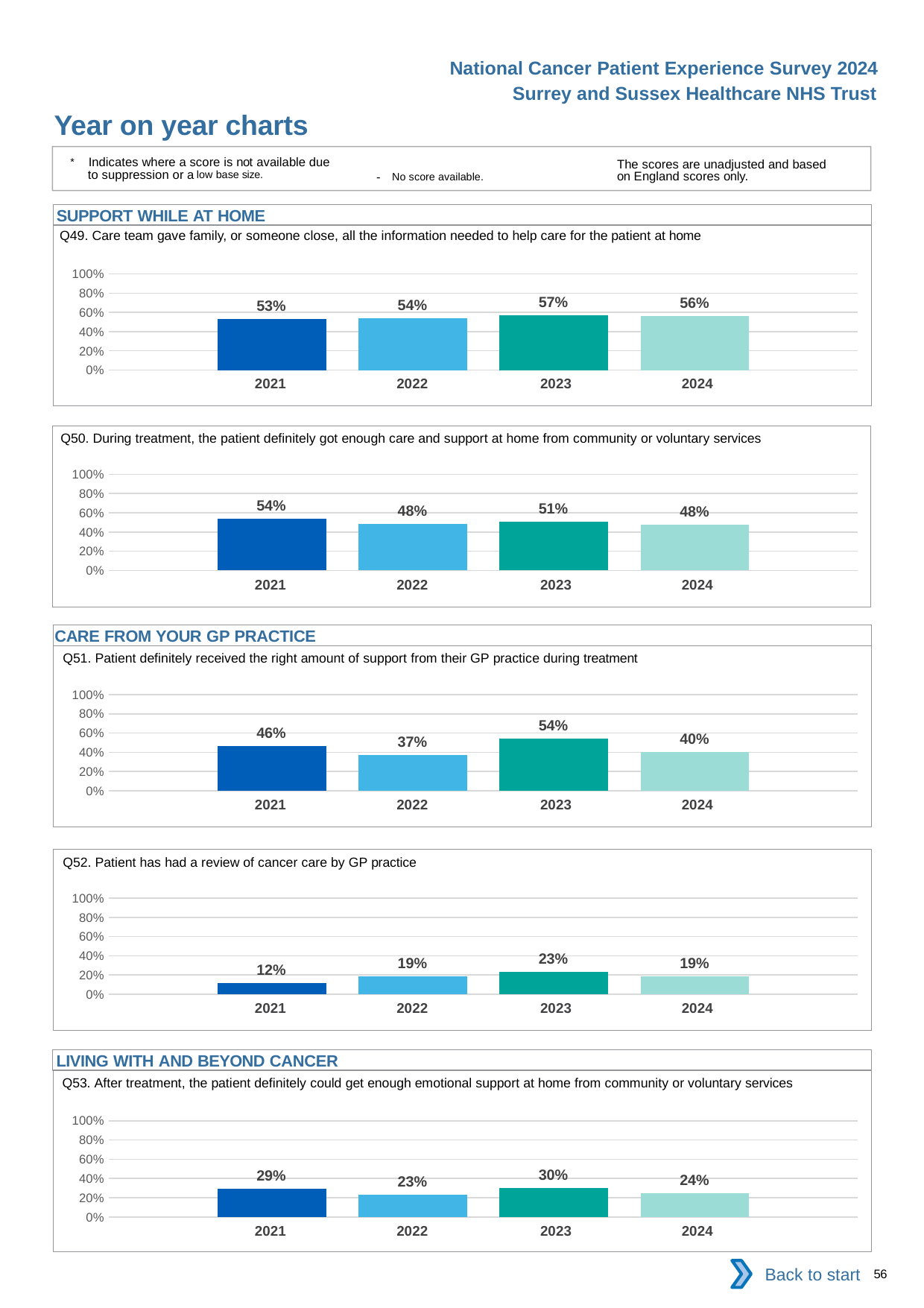
In the Q50 chart, what is the value for 2024? 48% In the Q49 chart, what is the value for 2023? 57% In the Q51 chart, which year has the lowest value? 2022 In the Q52 chart, does the value rise or fall from 2021 to 2023? rise In the Q51 chart, is the value for 2023 greater or less than 40%? greater What kind of chart is the Q52 chart? bar chart In the Q52 chart, what is the difference between the 2023 value and the 2021 value? 11% Which section heading appears above the Q53 chart? LIVING WITH AND BEYOND CANCER How many years are shown in the Q49 chart? 4 In the Q50 chart, which year has the highest value? 2021 In the Q53 chart, which is larger, the value for 2021 or the value for 2022? 2021 In the Q53 chart, what is the difference between the 2023 value and the 2024 value? 6%